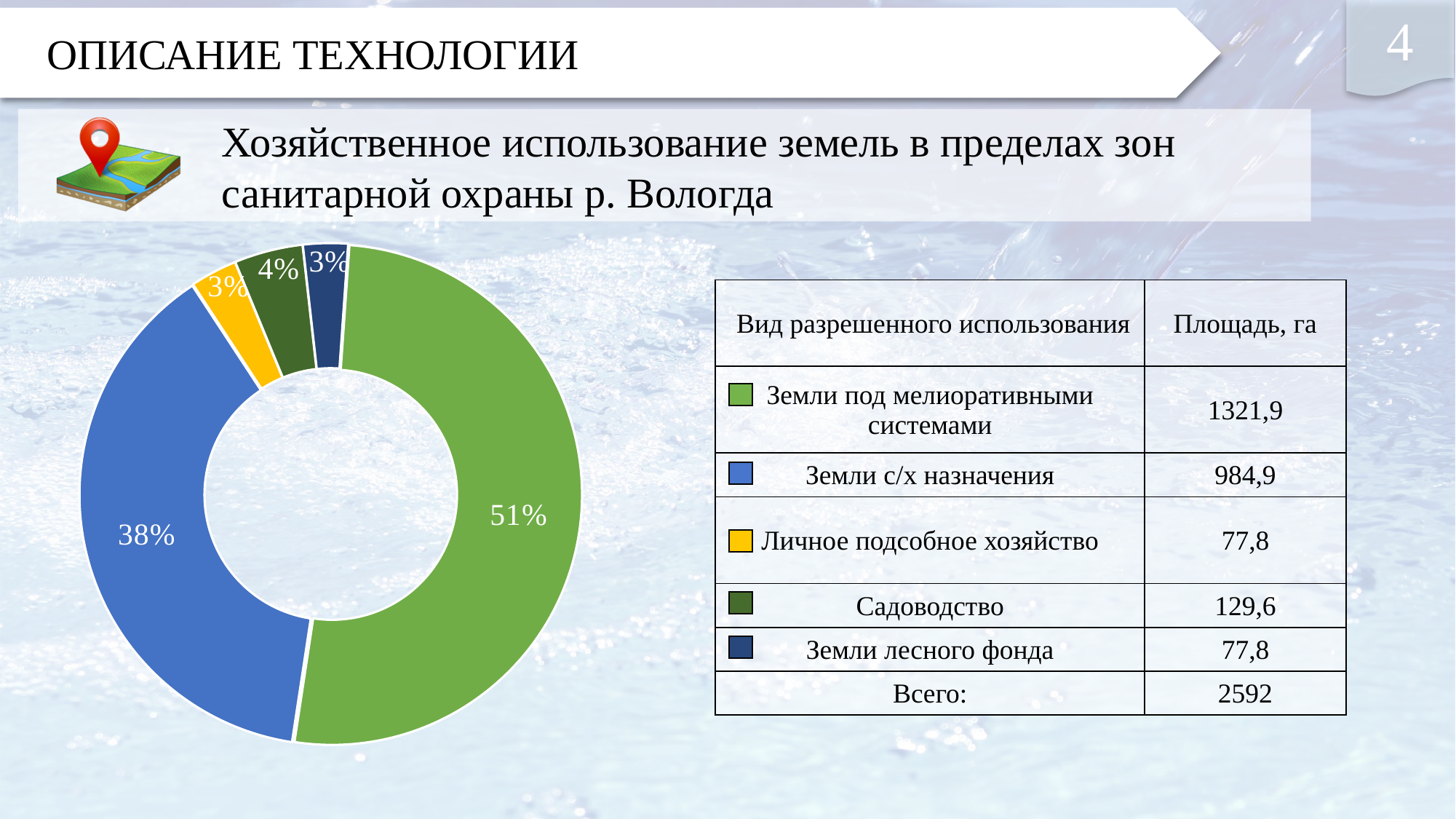
What share of the donut chart does the green slice (Земли под мелиоративными системами) represent? 51% What share of the donut chart does the yellow slice (Личное подсобное хозяйство) represent? 3% What kind of chart is shown on the slide? Pie (donut) chart What share of the donut chart does the blue slice (Земли с/х назначения) represent? 38% What is the difference in percentage points between the green slice (51%) and the blue slice (38%) in the donut chart? 13 What is the combined share of the two largest slices (51% and 38%) in the donut chart? 89% How many slices does the donut chart have? 5 Which is larger in the donut chart: the slice for Земли с/х назначения or the slice for Садоводство? Земли с/х назначения What colour is the slice representing Земли лесного фонда in the donut chart? Dark blue (navy) Which category has the largest slice in the donut chart? Земли под мелиоративными системами What is the title of the slide section containing the donut chart? Хозяйственное использование земель в пределах зон санитарной охраны р. Вологда